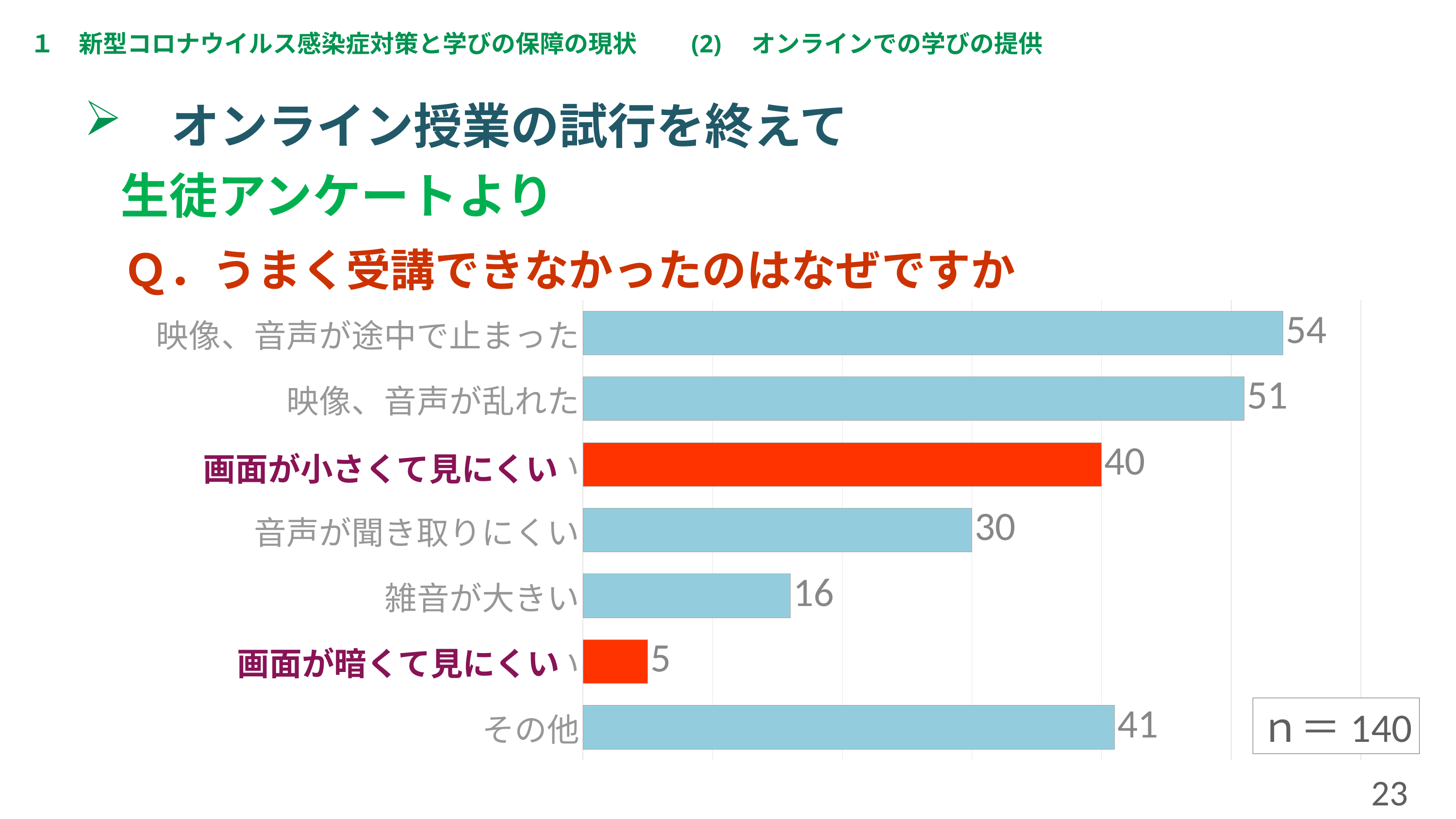
What is the value for 画面が小さくて見にくい? 40 Which is larger, the value for その他 or the value for 画面が小さくて見にくい? その他 What is the difference between the values for 映像、音声が乱れた and 音声が聞き取りにくい? 21 What is the difference between the values for 画面が小さくて見にくい and 画面が暗くて見にくい? 35 What is the value for その他? 41 What is the value for 映像、音声が途中で止まった? 54 Which category has the lowest value? 画面が暗くて見にくい What is the value for 雑音が大きい? 16 How many categories are shown in the chart? 7 What kind of chart is shown on the slide? bar chart Which categories are drawn with red-orange bars instead of light blue? 画面が小さくて見にくい and 画面が暗くて見にくい Which category has the highest value? 映像、音声が途中で止まった